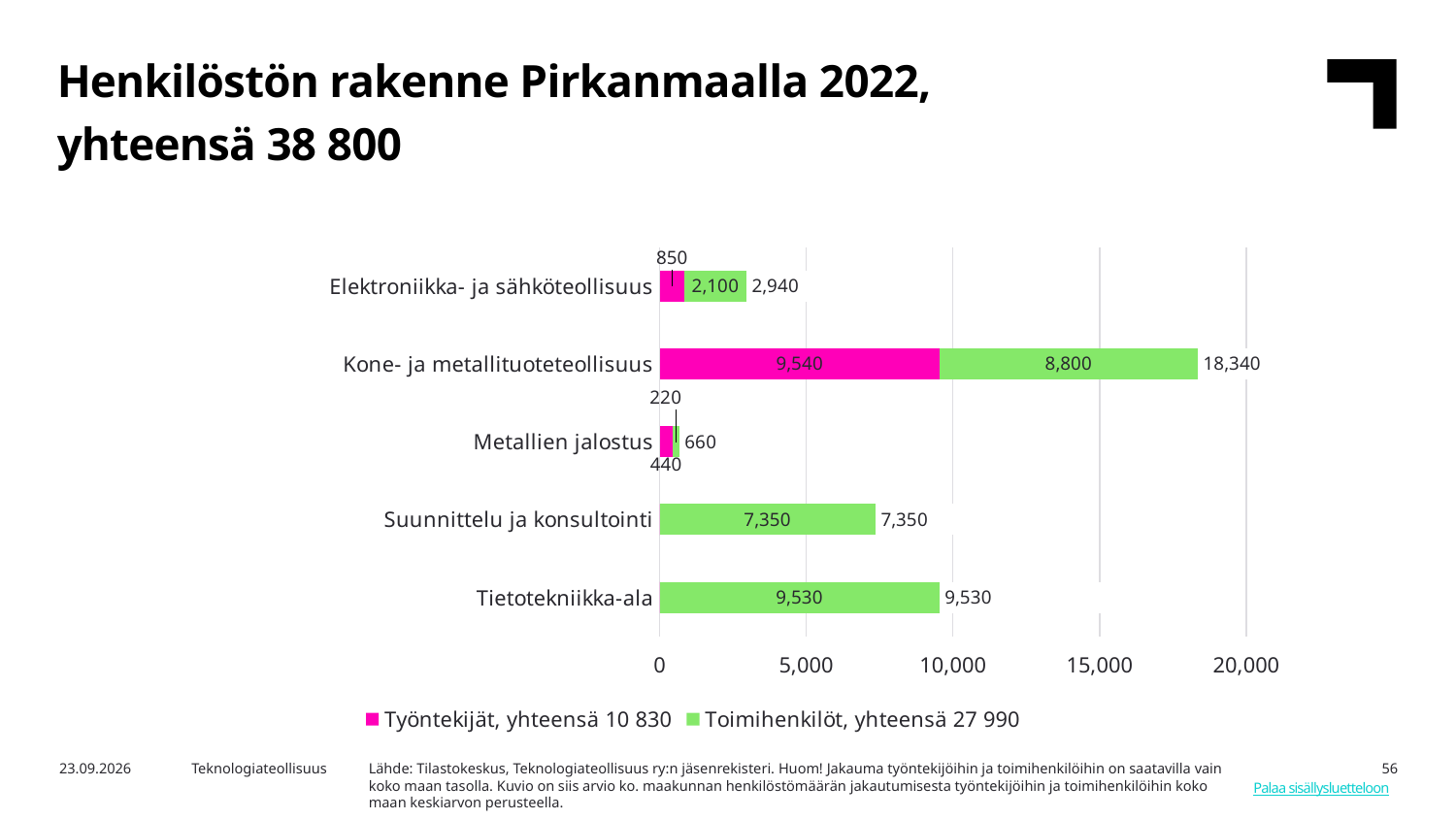
How many categories are shown on the chart? 5 Which category has the lowest total value? Metallien jalostus What is the title of the chart on the slide? Henkilöstön rakenne Pirkanmaalla 2022, yhteensä 38 800 What is the Työntekijät value for Kone- ja metallituoteteollisuus? 9,540 How many series does the legend list? 2 What is the total value for Metallien jalostus? 660 Which category has the highest total value? Kone- ja metallituoteteollisuus What is the difference between the Työntekijät and Toimihenkilöt values for Kone- ja metallituoteteollisuus? 740 Which is larger: the total for Tietotekniikka-ala or the total for Suunnittelu ja konsultointi? Tietotekniikka-ala What is the total value for Kone- ja metallituoteteollisuus? 18,340 What is the Toimihenkilöt value for Elektroniikka- ja sähköteollisuus? 2,100 What type of chart is shown on the slide? Stacked bar chart